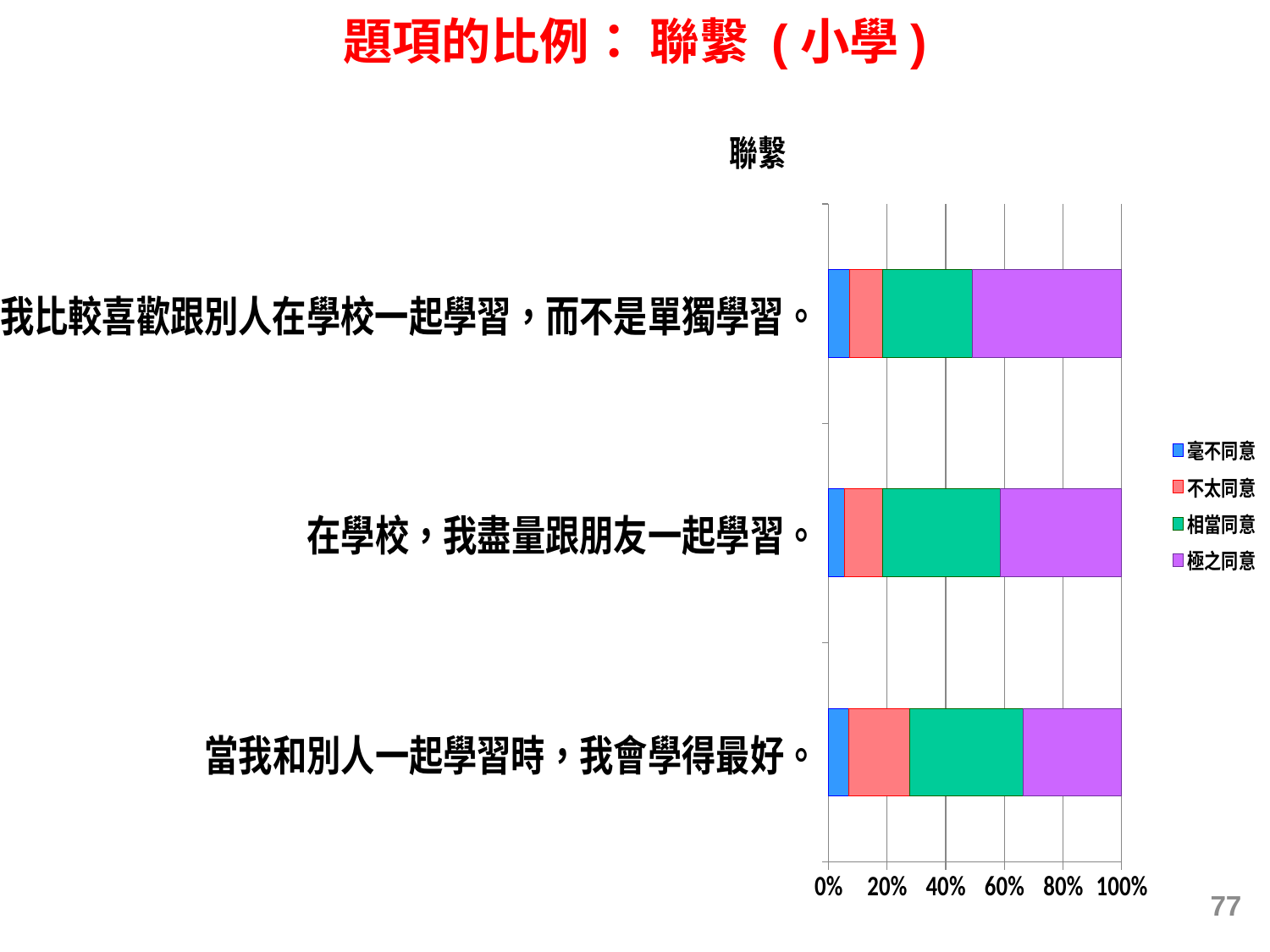
Is the 極之同意 share for 「我比較喜歡跟別人在學校一起學習，而不是單獨學習。」 greater or less than 40%? greater Is the 極之同意 share for 「當我和別人一起學習時，我會學得最好。」 greater or less than 40%? less Is the 極之同意 share for 「在學校，我盡量跟朋友一起學習。」 greater or less than 60%? less How many series does the legend list? 4 Which statement has the largest 不太同意 share? 當我和別人一起學習時，我會學得最好。 How many statements (categories) are plotted in the chart? 3 Which statement has the largest 極之同意 share? 我比較喜歡跟別人在學校一起學習，而不是單獨學習。 Which legend entry is shown in purple? 極之同意 What kind of chart is shown on the slide? Stacked bar chart What is the title of the chart? 聯繫 Which statement has a larger 極之同意 share: 「我比較喜歡跟別人在學校一起學習，而不是單獨學習。」 or 「當我和別人一起學習時，我會學得最好。」? 我比較喜歡跟別人在學校一起學習，而不是單獨學習。